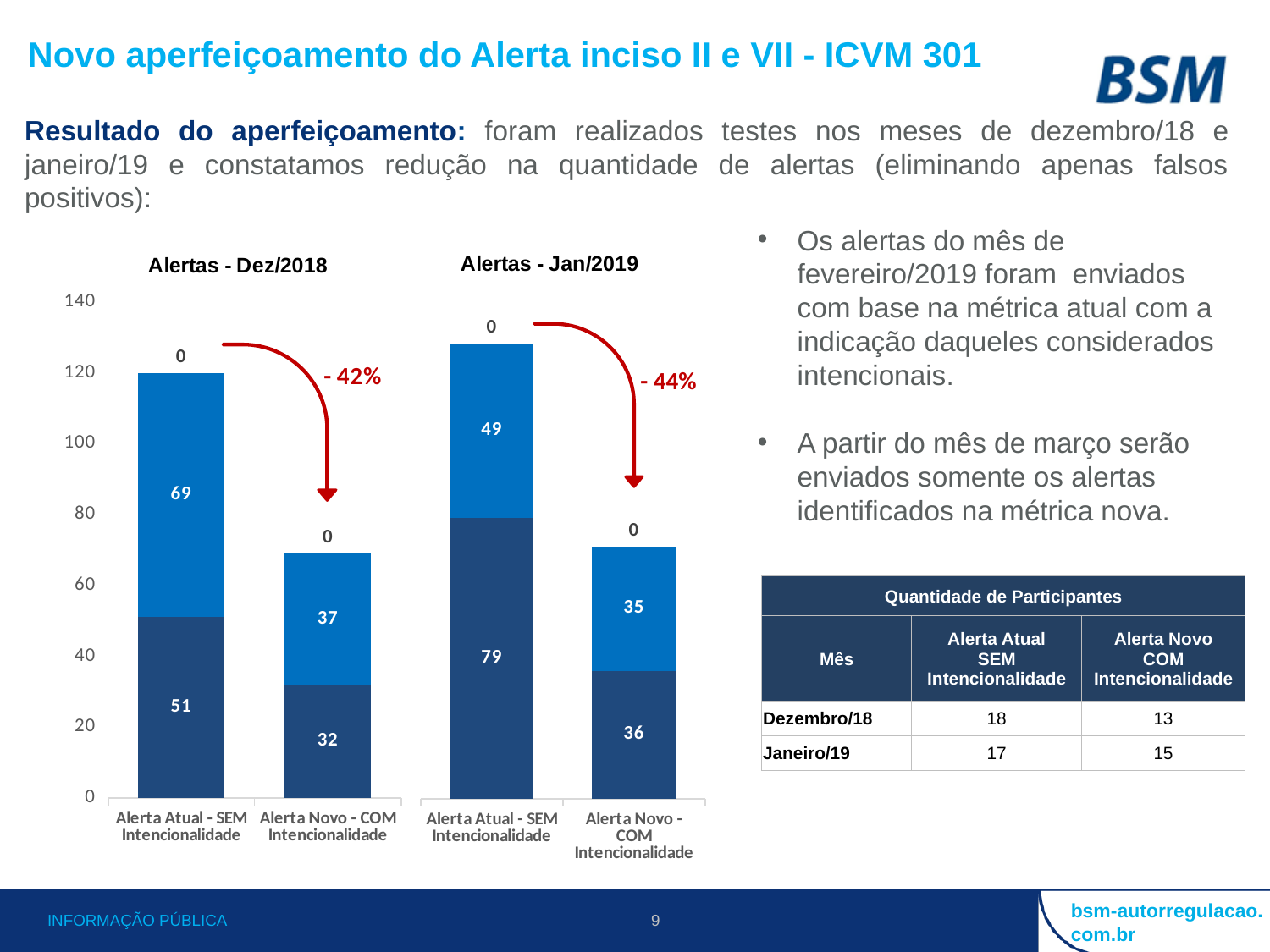
How many categories are shown on the x axis of the 'Alertas - Dez/2018' chart? 2 In the 'Alertas - Dez/2018' chart, what is the value of the top (light blue) segment of the 'Alerta Novo - COM Intencionalidade' bar? 37 In the 'Alertas - Jan/2019' chart, what is the total of the stacked bar for 'Alerta Novo - COM Intencionalidade'? 71 In the 'Alertas - Jan/2019' chart, is the total of the 'Alerta Atual - SEM Intencionalidade' bar greater or less than 120? greater What type of chart is 'Alertas - Jan/2019'? Stacked bar chart In the 'Alertas - Jan/2019' chart, which bar is taller, 'Alerta Atual - SEM Intencionalidade' or 'Alerta Novo - COM Intencionalidade'? Alerta Atual - SEM Intencionalidade In the 'Alertas - Jan/2019' chart, what is the value of the bottom (dark blue) segment of the 'Alerta Atual - SEM Intencionalidade' bar? 79 In the 'Alertas - Dez/2018' chart, what is the value of the bottom (dark blue) segment of the 'Alerta Atual - SEM Intencionalidade' bar? 51 In the 'Alertas - Dez/2018' chart, what is the difference between the dark blue segments of 'Alerta Atual - SEM Intencionalidade' and 'Alerta Novo - COM Intencionalidade'? 19 In the 'Alertas - Dez/2018' chart, what is the total of the stacked bar for 'Alerta Atual - SEM Intencionalidade'? 120 What percentage reduction is annotated with the red arrow on the 'Alertas - Dez/2018' chart? - 42% In the 'Alertas - Jan/2019' chart, what is the value of the top (light blue) segment of the 'Alerta Novo - COM Intencionalidade' bar? 35